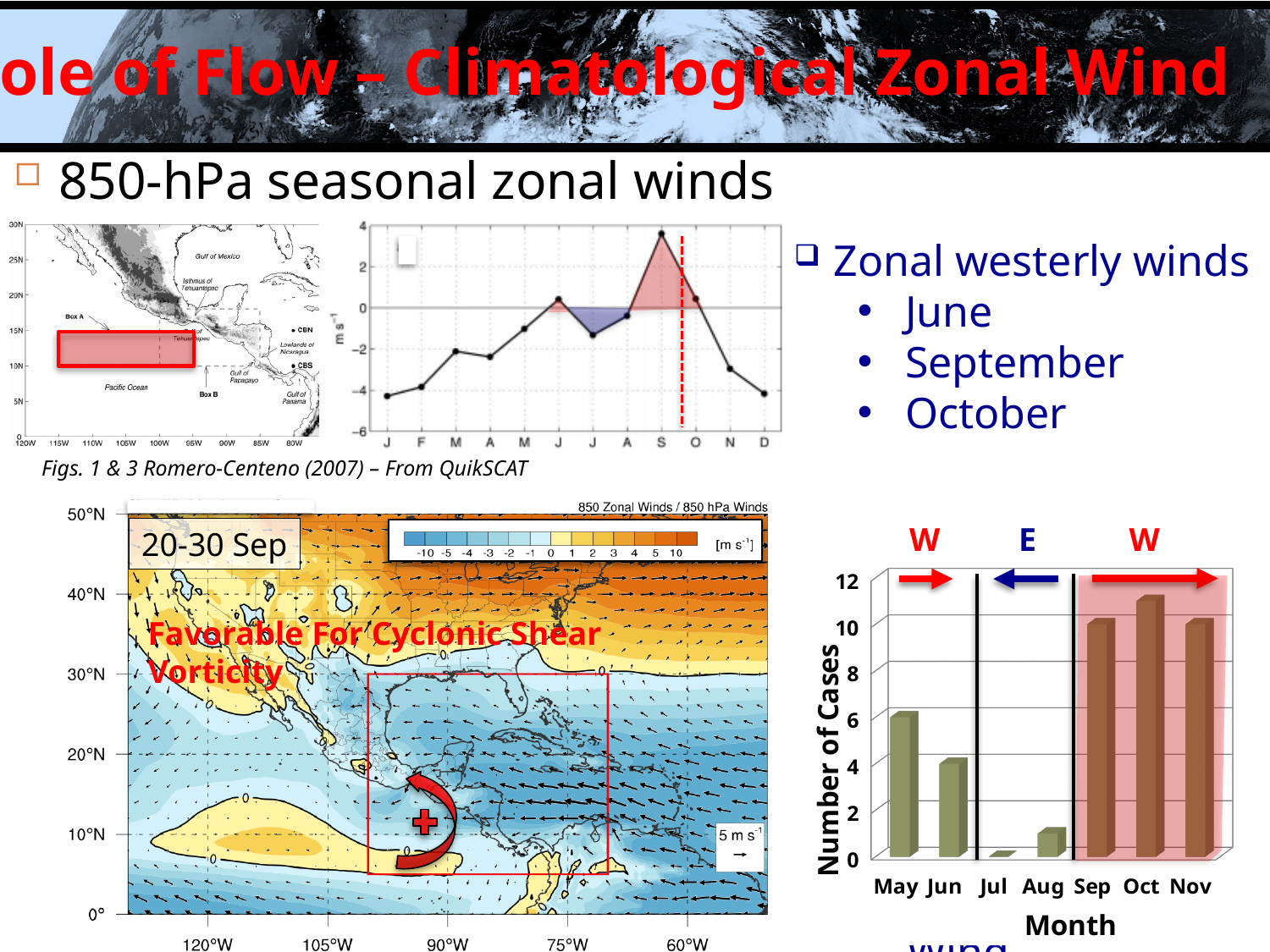
In the bar chart of Number of Cases by Month, what type of chart is it? bar chart In the bar chart of Number of Cases by Month, which month has the lowest number of cases? Jul In the bar chart of Number of Cases by Month, what is the label of the y axis? Number of Cases In the bar chart of Number of Cases by Month, which month has the highest number of cases? Oct In the bar chart of Number of Cases by Month, is the number of cases for Oct greater or less than 10? greater In the bar chart of Number of Cases by Month, is the number of cases for Aug greater or less than 2? less In the line chart of 850-hPa seasonal zonal winds (top middle), is the value for S greater or less than 2? greater In the bar chart of Number of Cases by Month, what is the number of cases for Jun? 4 In the line chart of 850-hPa seasonal zonal winds (top middle), which month has the highest value? S In the bar chart of Number of Cases by Month, which has more cases, May or Sep? Sep In the bar chart of Number of Cases by Month, how many months are shown on the x axis? 7 In the bar chart of Number of Cases by Month, what is the number of cases for May? 6